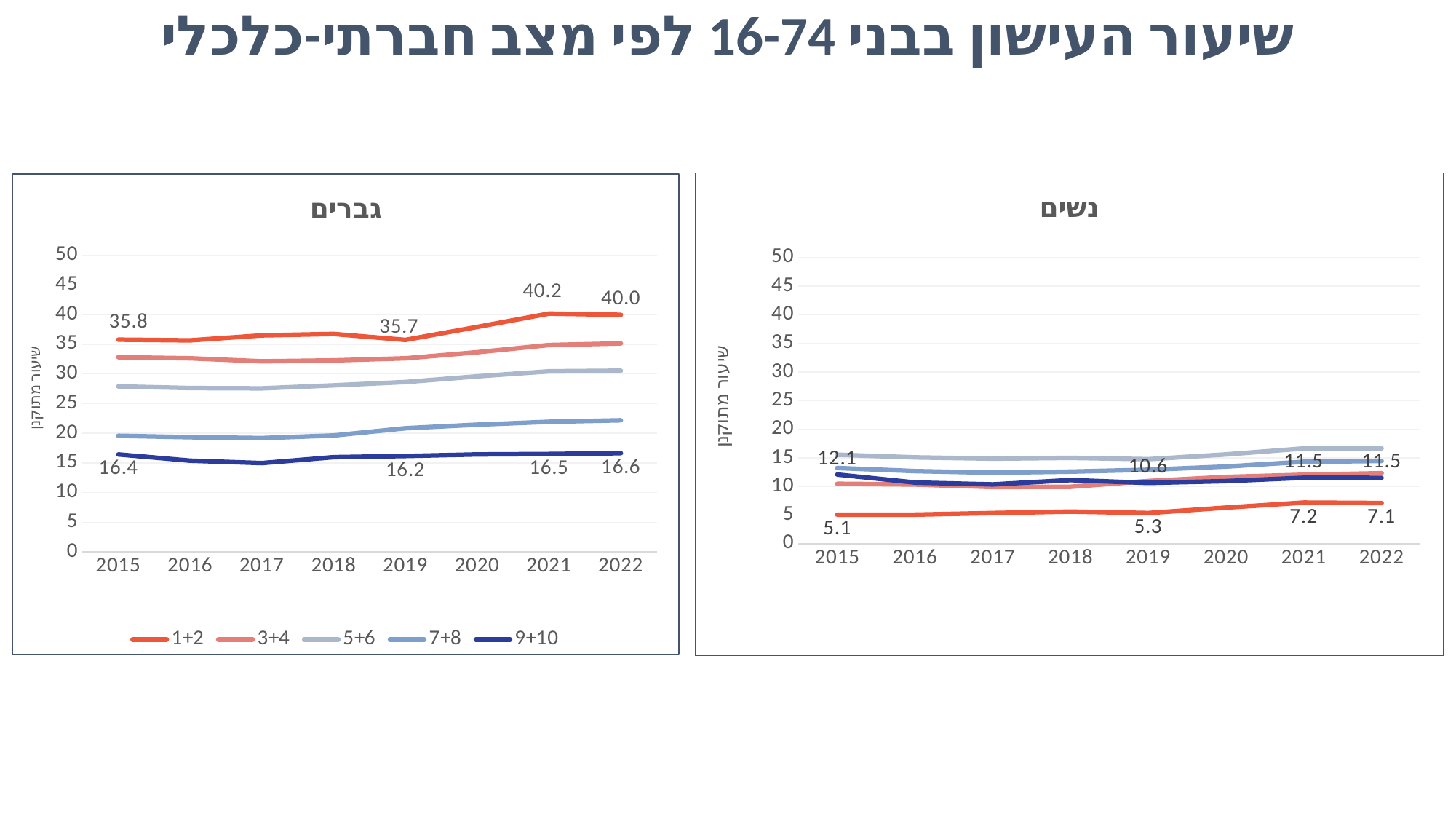
In the גברים chart, how many years are shown on the x axis? 8 In the גברים chart, what is the value of the 1+2 series in 2015? 35.8 In the גברים chart, how many series does the legend list? 5 In the נשים chart, by how much did the lowest (orange) line change from 2015 to 2021? 2.1 In the נשים chart, what is the value of the lowest (orange) line in 2022? 7.1 In the גברים chart, what is the value of the 9+10 series in 2022? 16.6 In the גברים chart, what is the difference between the 1+2 and 9+10 series in 2022? 23.4 In the גברים chart, is the value of the 1+2 series in 2022 greater or less than 35? greater What kind of chart is the גברים chart? Line chart In the נשים chart, what is the value of the lowest (orange) line in 2015? 5.1 In the גברים chart, what is the value of the 1+2 series in 2021? 40.2 In the גברים chart, which series has the highest values across all years? 1+2